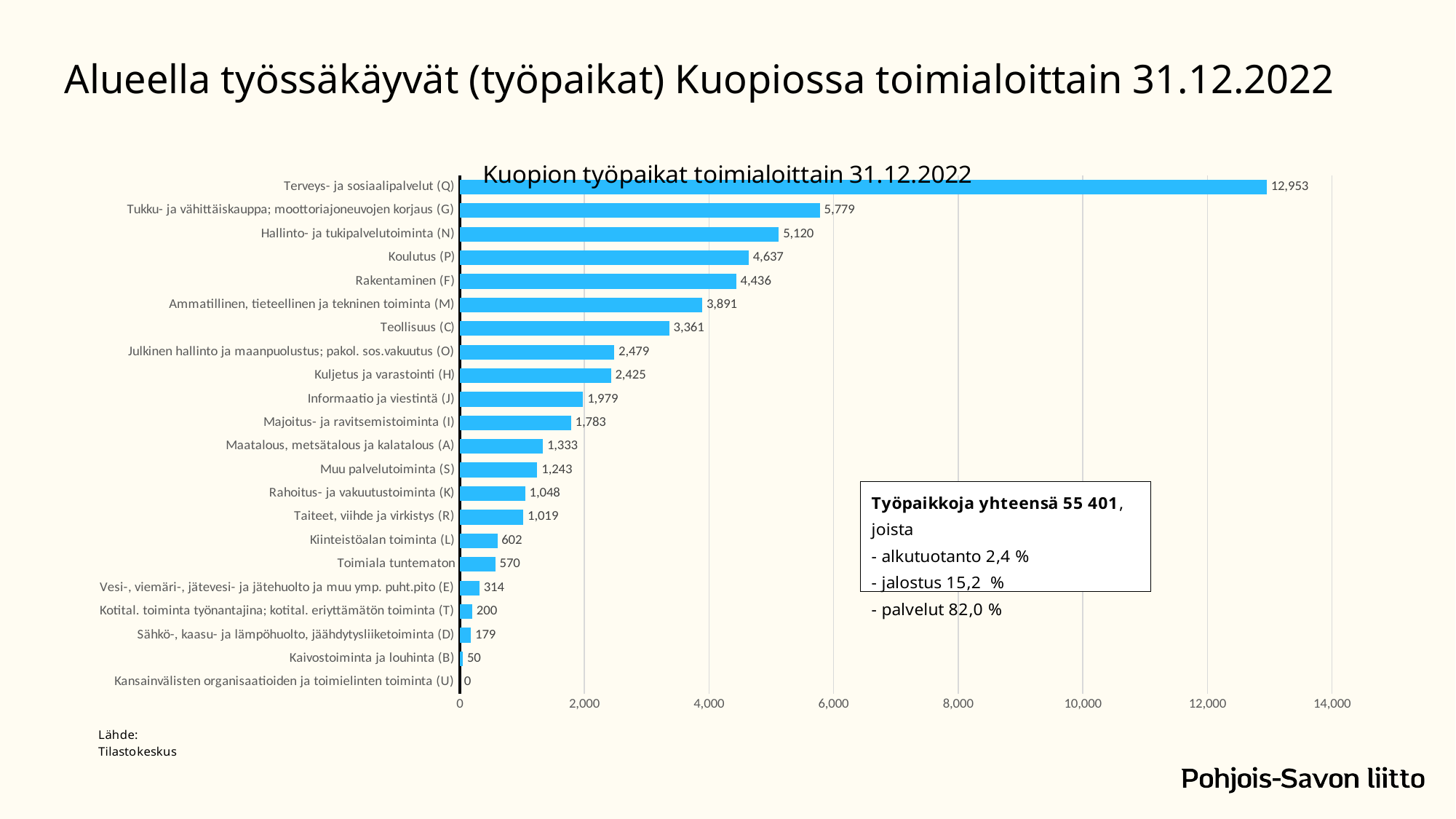
What is the difference between Tukku- ja vähittäiskauppa; moottoriajoneuvojen korjaus (G) and Hallinto- ja tukipalvelutoiminta (N)? 659 What is the value for Terveys- ja sosiaalipalvelut (Q)? 12,953 What is the value for Koulutus (P)? 4,637 What is the difference between Koulutus (P) and Rakentaminen (F)? 201 How many categories are shown in the chart? 22 What type of chart is shown on the slide? bar chart What is the value for Kuljetus ja varastointi (H)? 2,425 Which category has the highest value? Terveys- ja sosiaalipalvelut (Q) Which is larger, Teollisuus (C) or Ammatillinen, tieteellinen ja tekninen toiminta (M)? Ammatillinen, tieteellinen ja tekninen toiminta (M) Is the value for Rakentaminen (F) greater or less than 4,000? greater What is the value for Kaivostoiminta ja louhinta (B)? 50 Which category has the lowest value? Kansainvälisten organisaatioiden ja toimielinten toiminta (U)